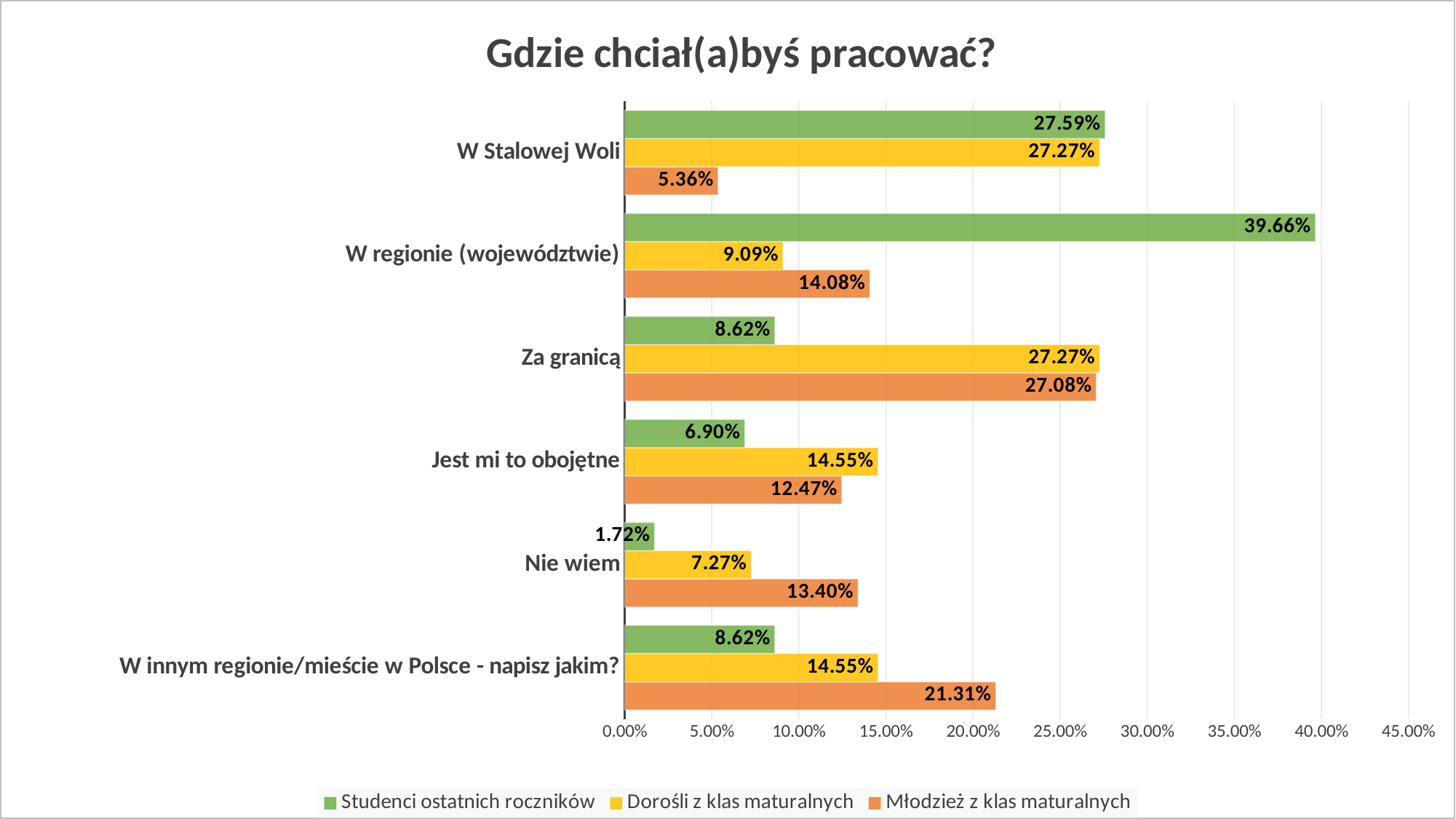
In the category W innym regionie/mieście w Polsce - napisz jakim?, which series has the larger value: Dorośli z klas maturalnych or Młodzież z klas maturalnych? Młodzież z klas maturalnych What is the difference between the Młodzież z klas maturalnych value and the Studenci ostatnich roczników value in the category Nie wiem? 11.68% What kind of chart is shown on the slide? bar chart Which category has the highest value for Studenci ostatnich roczników? W regionie (województwie) Which category has the lowest value for Studenci ostatnich roczników? Nie wiem What is the title of the chart? Gdzie chciał(a)byś pracować? What is the value for Dorośli z klas maturalnych in the category Za granicą? 27.27% What is the value for Młodzież z klas maturalnych in the category W Stalowej Woli? 5.36% Which category has the highest value for Młodzież z klas maturalnych? Za granicą What is the value for Studenci ostatnich roczników in the category W regionie (województwie)? 39.66% How many categories are shown on the chart? 6 How many series does the legend list? 3